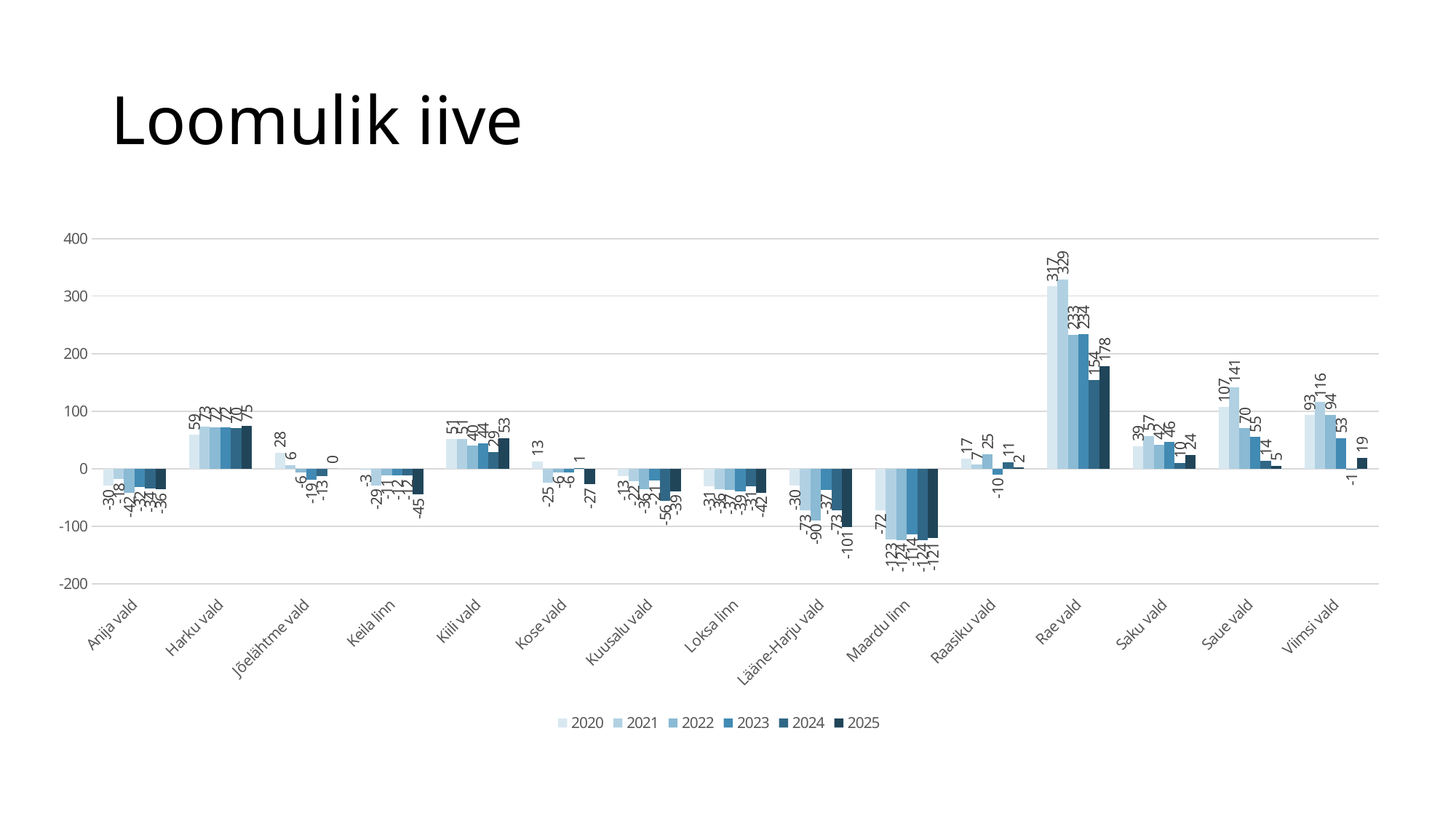
Which category has the highest value in 2021? Rae vald What is the value for Maardu linn in 2020? -72 What is the difference between the 2021 and 2020 values for Saue vald? 34 What is the value for Rae vald in 2021? 329 What is the value for Lääne-Harju vald in 2025? -101 Which category has the lowest value in 2025? Maardu linn How many series does the legend list? 6 How many categories are shown on the x axis? 15 Which is larger: the 2021 value for Saue vald or the 2021 value for Viimsi vald? Saue vald What is the value for Viimsi vald in 2024? -1 What is the value for Jõelähtme vald in 2025? 0 What is the title of the chart? Loomulik iive